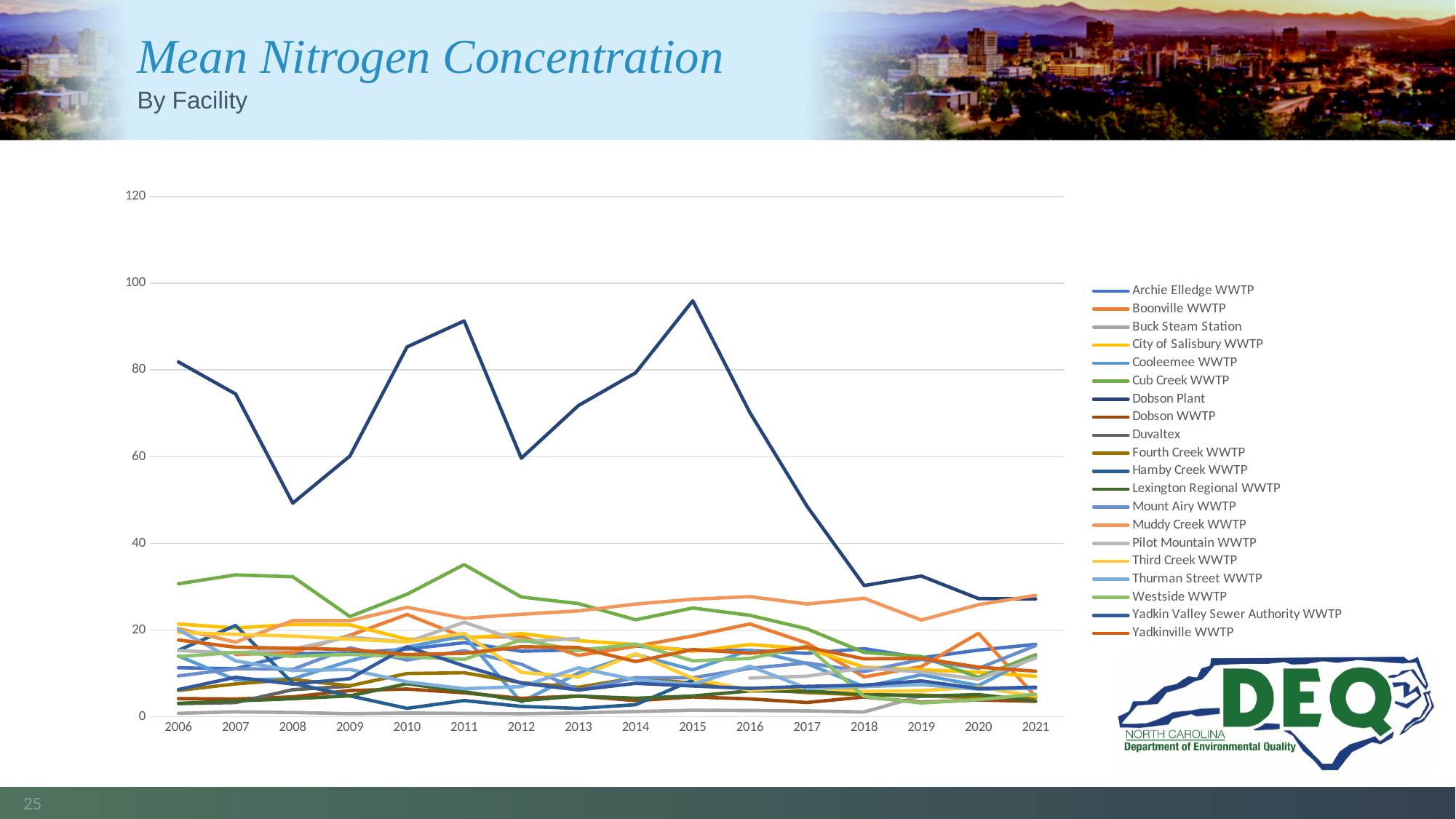
What kind of chart is shown on the slide? line chart What is the title of the chart on the slide? Mean Nitrogen Concentration How many facilities does the legend list? 20 Is the value for Dobson Plant in 2008 greater or less than 60? less Is the value for Dobson Plant in 2015 greater or less than 80? greater Which facility has the highest mean nitrogen concentration in 2015? Dobson Plant How many years are shown along the x axis? 16 Does the Dobson Plant line rise or fall between 2015 and 2018? fall Is the value for Dobson Plant in 2011 greater or less than 80? greater Which is larger for Dobson Plant, the value in 2012 or the value in 2015? 2015 In which year does the Dobson Plant line reach its highest value? 2015